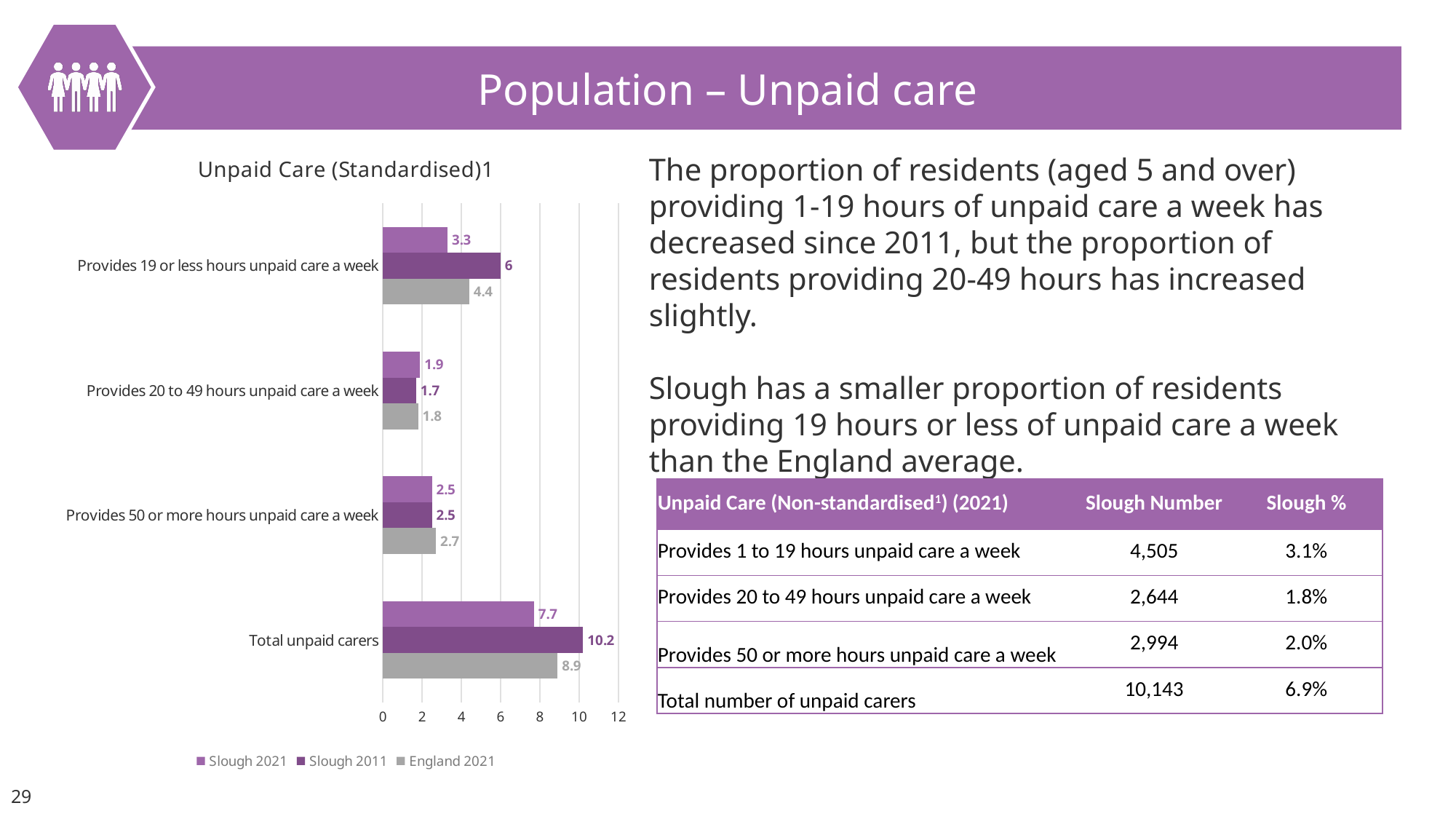
Which category has the highest Slough 2011 value? Total unpaid carers What is the difference between the Slough 2011 and Slough 2021 values for Total unpaid carers? 2.5 What is the title of the chart? Unpaid Care (Standardised)1 How many categories are shown on the chart? 4 Which category has the lowest Slough 2021 value? Provides 20 to 49 hours unpaid care a week Is the England 2021 value for Total unpaid carers greater or less than 8? greater For Provides 19 or less hours unpaid care a week, which is larger: the Slough 2021 value or the England 2021 value? England 2021 How many series does the legend list? 3 What is the Slough 2011 value for Provides 19 or less hours unpaid care a week? 6 What is the Slough 2021 value for Total unpaid carers? 7.7 What is the England 2021 value for Provides 50 or more hours unpaid care a week? 2.7 What kind of chart is shown on the slide? Bar chart